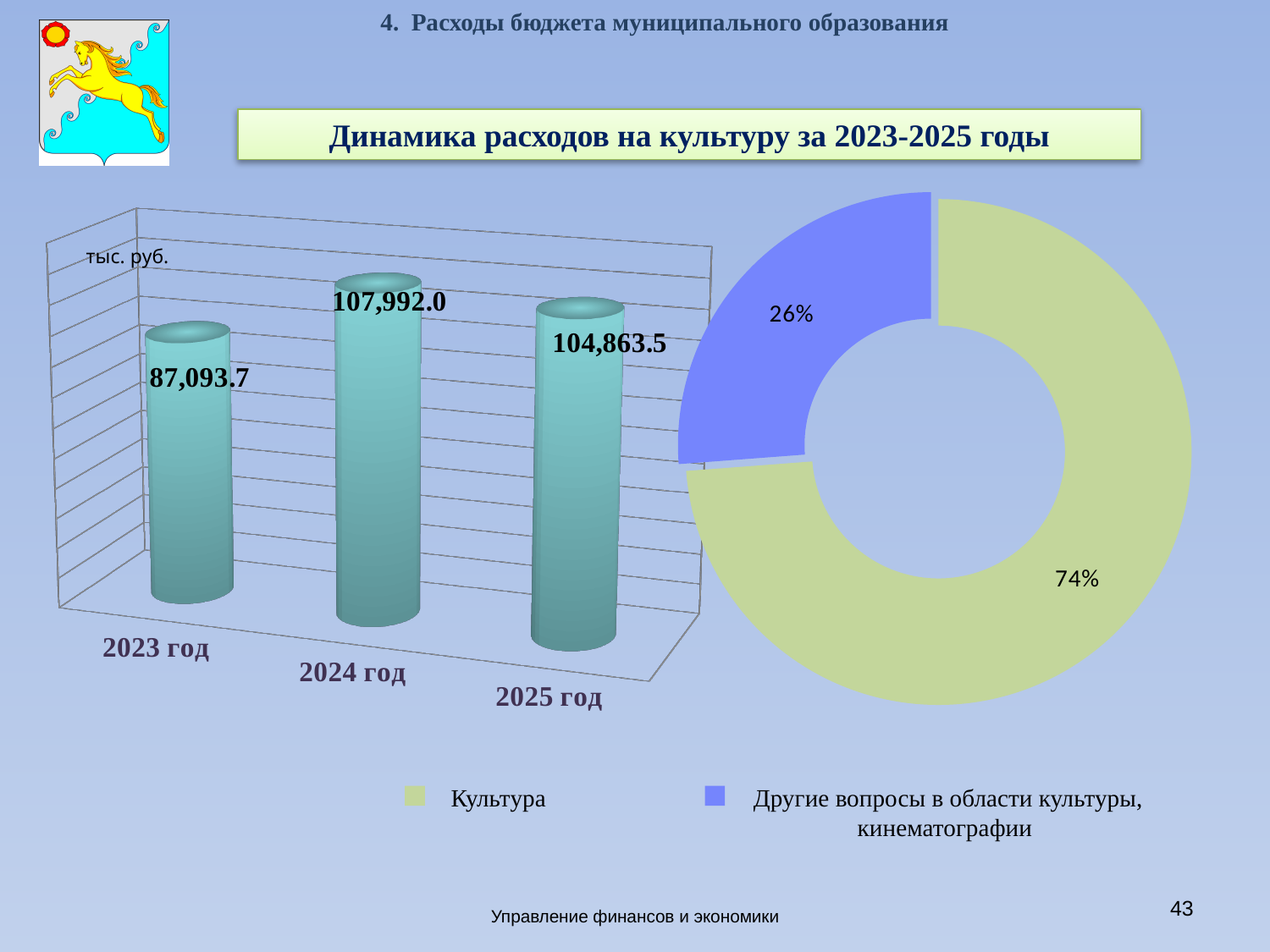
In the bar chart on the left, what is the value for 2023 год? 87,093.7 In the bar chart on the left, what is the value for 2025 год? 104,863.5 In the bar chart on the left, which year has the lowest value? 2023 год In the bar chart on the left, which year has the highest value? 2024 год In the doughnut chart on the right, what share does Культура have? 74% In the bar chart on the left, what is the value for 2024 год? 107,992.0 What kind of chart is the chart on the left of the slide? Bar chart How many years are shown in the bar chart on the left? 3 In the bar chart on the left, what is the difference between the values for 2024 год and 2023 год? 20,898.3 What unit is indicated on the bar chart on the left? тыс. руб. In the doughnut chart on the right, what share does Другие вопросы в области культуры, кинематографии have? 26% In the bar chart on the left, which is larger: the value for 2025 год or the value for 2023 год? 2025 год